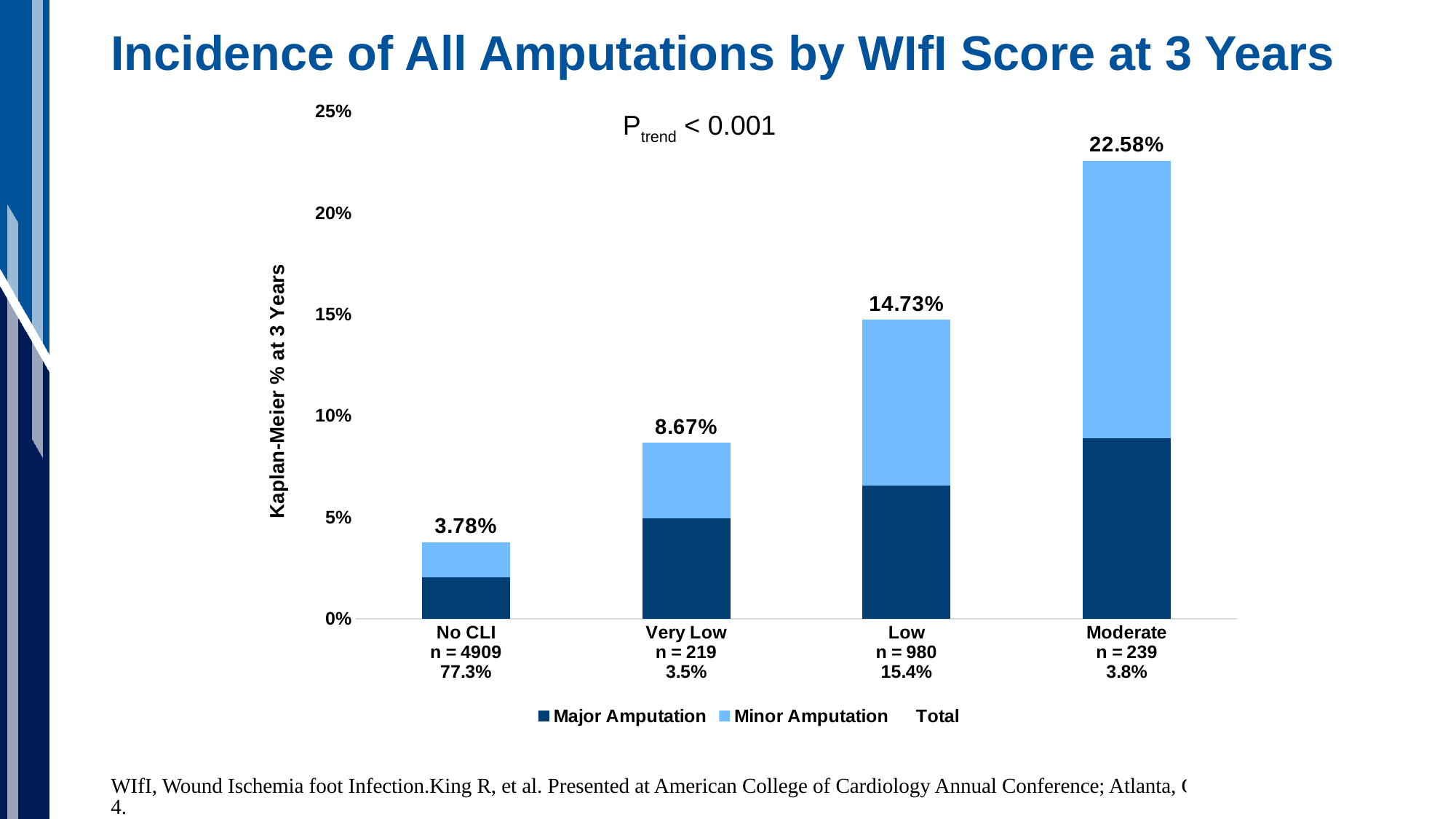
Which has a higher total amputation incidence, Very Low or Low? Low Do the total amputation values rise or fall from No CLI to Moderate along the x axis? Rise Which WIfI group has the highest total amputation incidence? Moderate How many entries does the legend list? 3 Which group has the lowest total amputation incidence? No CLI Is the Major Amputation value for the Moderate group greater or less than 5%? greater What is the total amputation incidence shown for the No CLI group? 3.78% What is the total amputation incidence shown for the Low WIfI group? 14.73% What is the total amputation incidence shown for the Moderate WIfI group? 22.58% How many WIfI groups are shown on the x axis? 4 What is the difference between the total amputation incidence for the Moderate group and the Low group? 7.85% What kind of chart is shown on the slide? Stacked bar chart